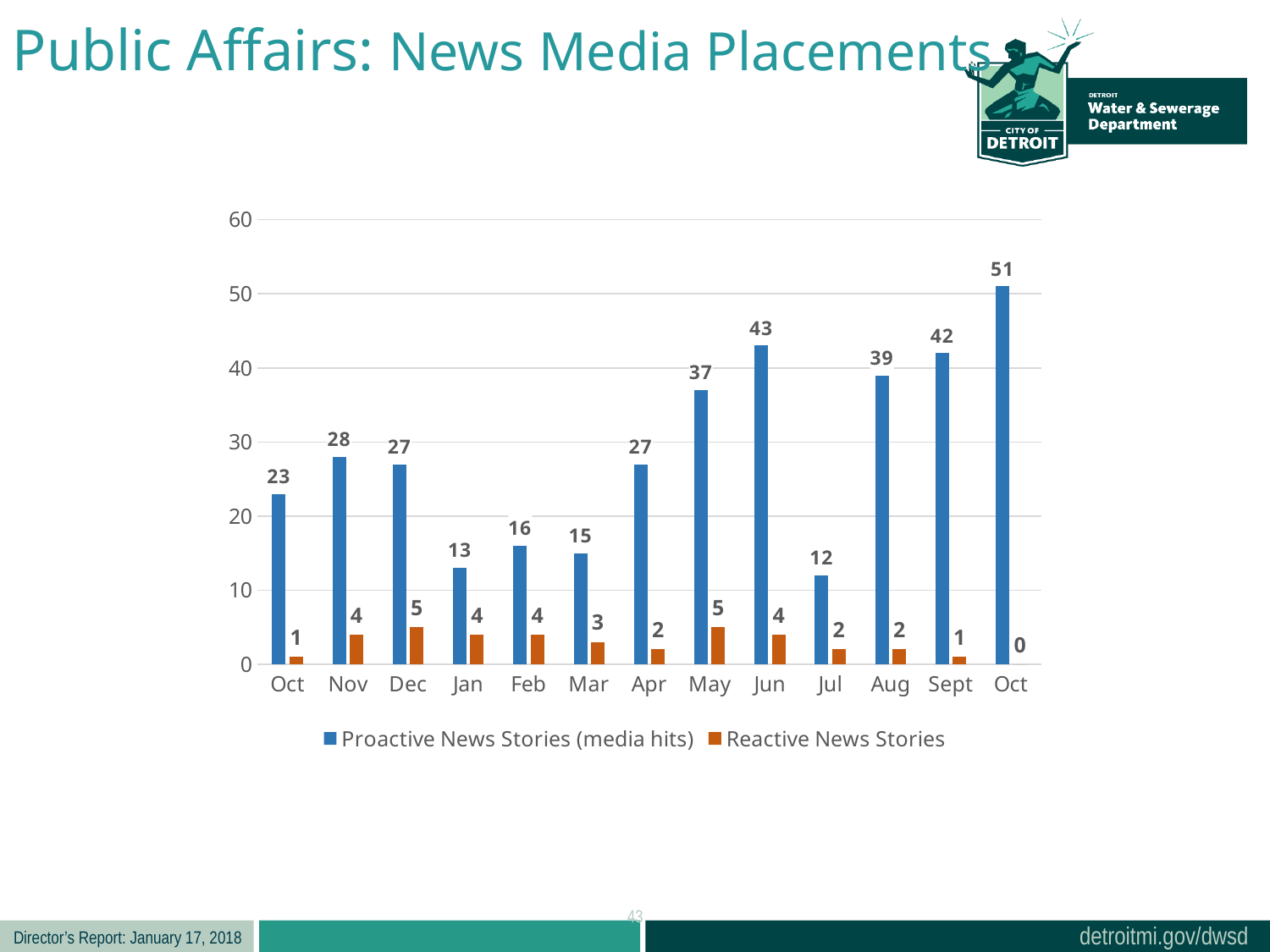
What is the value of Proactive News Stories (media hits) for Jul? 12 How many series does the legend list? 2 What is the difference between Proactive News Stories (media hits) in Sept and in Aug? 3 Which month has the highest value for Proactive News Stories (media hits)? Oct (the last month on the axis) Which is larger: Proactive News Stories (media hits) in May or in Apr? May Which month has the lowest value for Reactive News Stories? Oct (the last month on the axis) What is the total of Proactive News Stories (media hits) and Reactive News Stories for Nov? 32 Which month has the lowest value for Proactive News Stories (media hits)? Jul What is the value of Reactive News Stories for Dec? 5 How many months are shown on the x axis? 13 What kind of chart is shown on the slide? Bar chart What is the value of Proactive News Stories (media hits) for Jun? 43